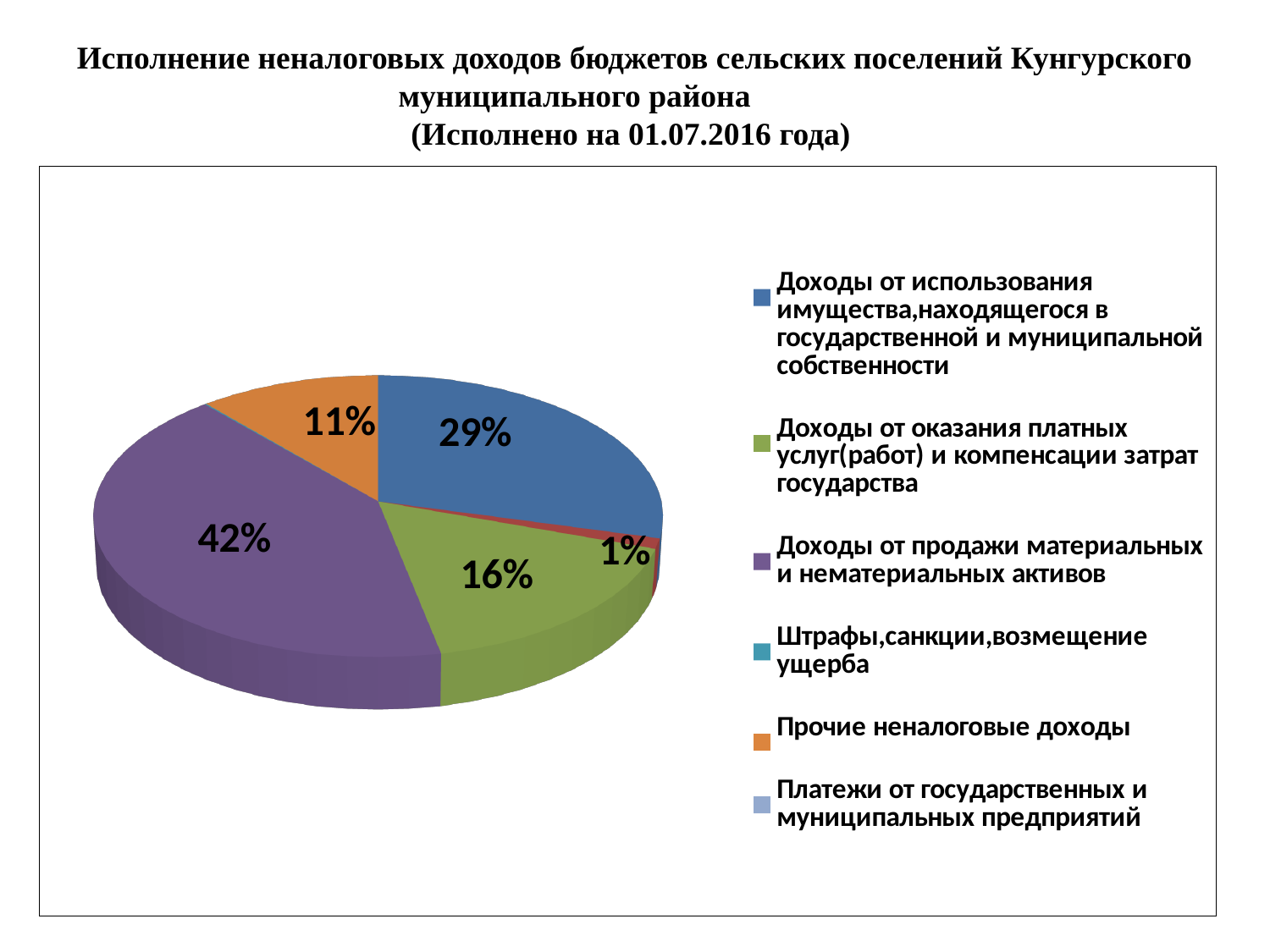
Which category has the largest slice of the pie? Доходы от продажи материальных и нематериальных активов Which slice is larger: "Доходы от оказания платных услуг(работ) и компенсации затрат государства" or "Прочие неналоговые доходы"? Доходы от оказания платных услуг(работ) и компенсации затрат государства By how many percentage points does the slice for "Доходы от продажи материальных и нематериальных активов" exceed the slice for "Доходы от использования имущества,находящегося в государственной и муниципальной собственности"? 13 percentage points How many entries does the legend list? 6 How many percentage labels are shown on the pie? 5 What kind of chart is shown on the slide? pie chart What is the smallest percentage label shown on the pie? 1% What date is given in the chart title as the execution date? 01.07.2016 What share of the pie is labelled for "Прочие неналоговые доходы"? 11% What share of the pie is labelled for "Доходы от продажи материальных и нематериальных активов"? 42% What share of the pie is labelled for "Доходы от использования имущества,находящегося в государственной и муниципальной собственности"? 29%